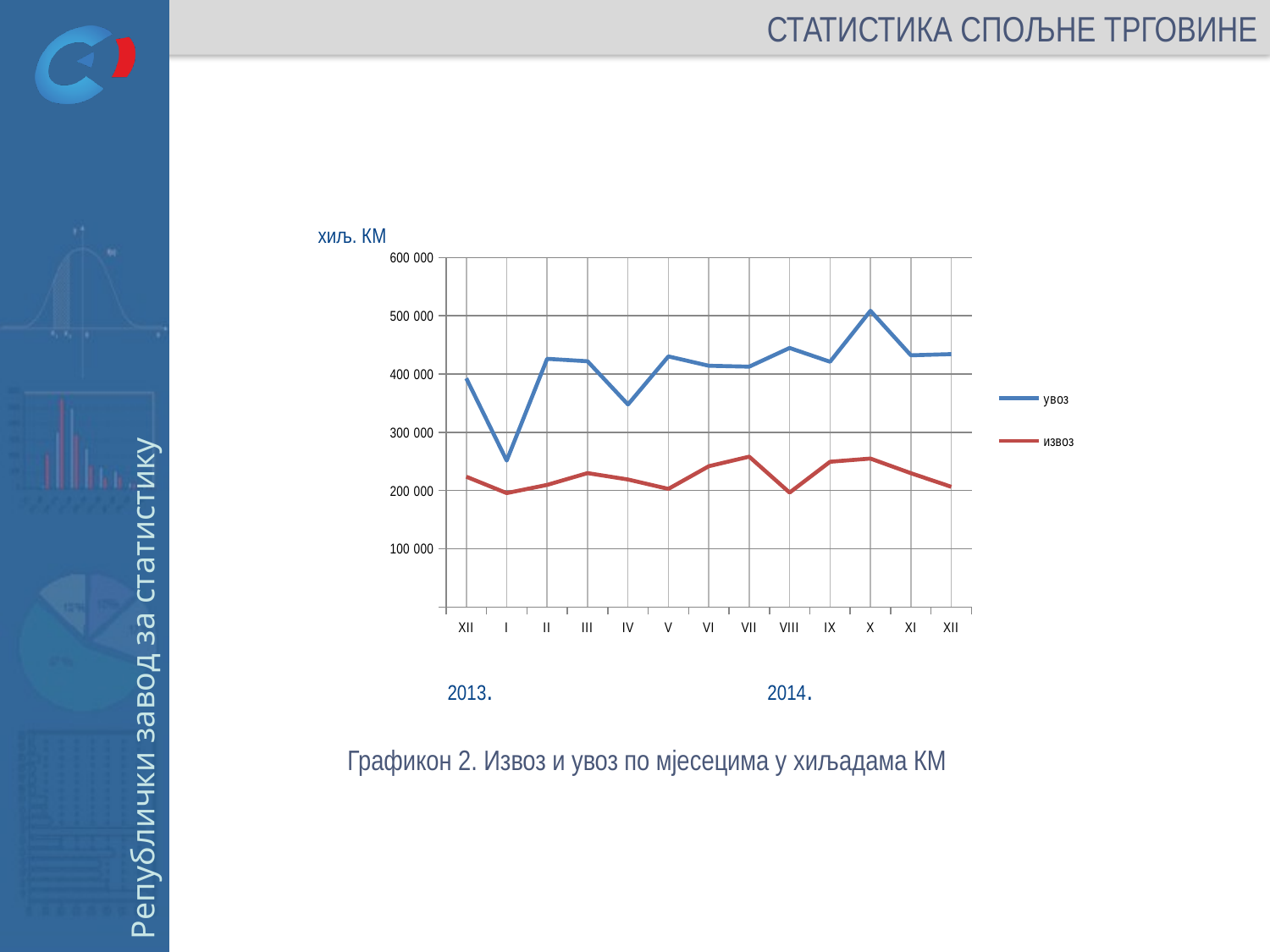
What kind of chart is shown on the slide? line chart Which series has the larger value in month VI, увоз or извоз? увоз How many series does the legend list? 2 In which month does the увоз series reach its lowest value? I Which colour represents the извоз series in the legend? red Is the value of увоз in month IV greater or less than 400 000? less How many months are plotted along the x axis? 13 Is the value of извоз in month VII greater or less than 300 000? less Is the value of увоз in month X greater or less than 400 000? greater Does the увоз series rise or fall from XII 2013 to I 2014? fall In which month does the увоз series reach its highest value? X